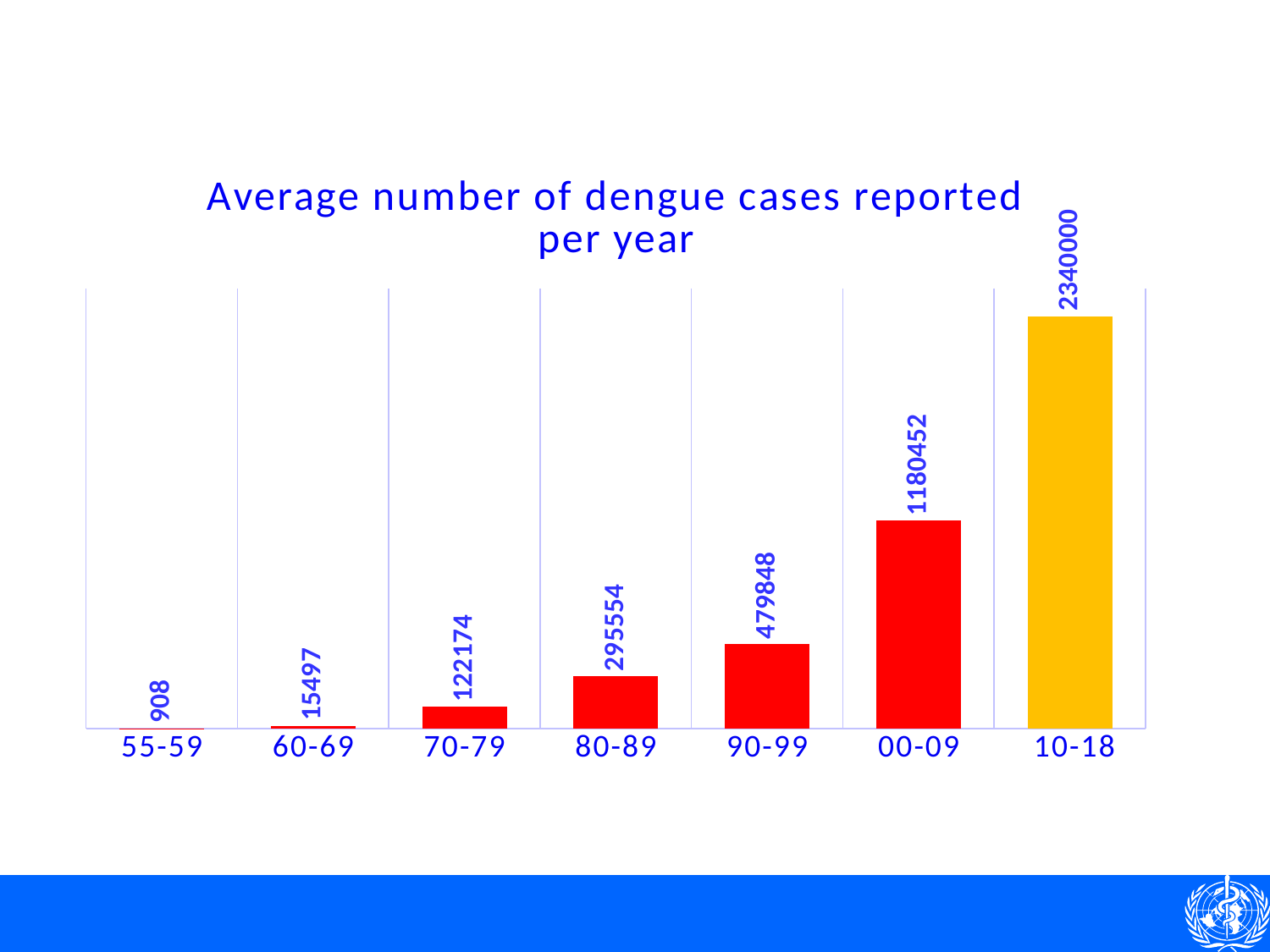
What is the value shown for the 00-09 period? 1180452 Which bar is coloured differently from the others? 10-18 What kind of chart is shown on the slide? Bar chart Do the values rise or fall from 55-59 to 10-18? Rise What is the difference between the values for 90-99 and 80-89? 184294 Which period has the lowest average number of dengue cases reported per year? 55-59 What is the average number of dengue cases reported per year for 80-89? 295554 What is the difference between the values for 10-18 and 00-09? 1159548 How many periods are shown on the x axis? 7 Which period has the highest average number of dengue cases reported per year? 10-18 Which is larger, the value for 70-79 or the value for 60-69? 70-79 What is the value shown for the 55-59 period? 908